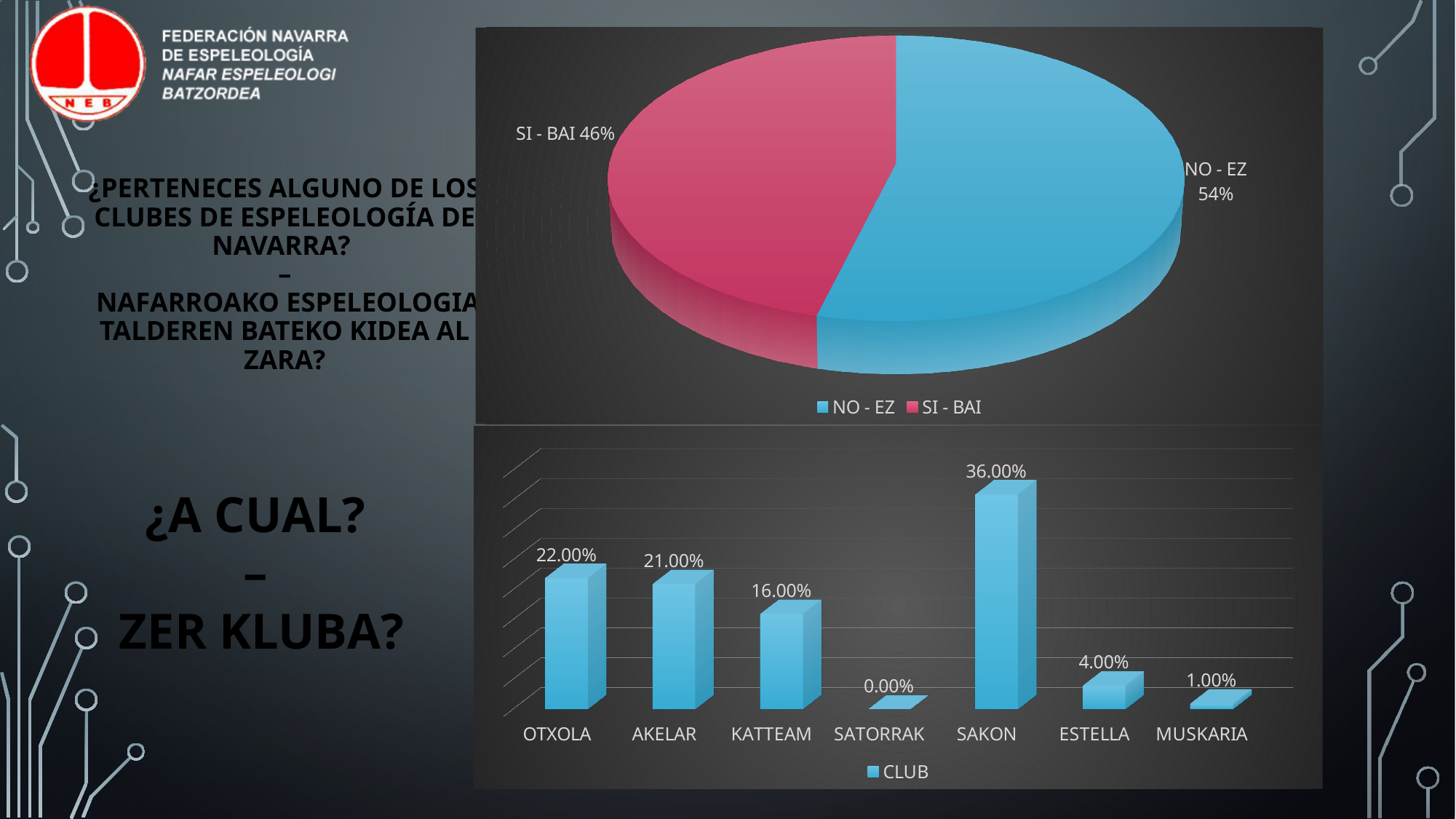
In the bar chart at the bottom of the slide, which club has the highest value? SAKON What kind of chart is the chart at the bottom of the slide? Bar chart In the bar chart at the bottom of the slide, what is the difference between the values for OTXOLA and AKELAR? 1.00% In the pie chart at the top of the slide, how many entries does the legend list? 2 In the pie chart at the top of the slide, what share does NO - EZ have? 54% In the bar chart at the bottom of the slide, what is the value for KATTEAM? 16.00% In the bar chart at the bottom of the slide, how many clubs are shown on the x axis? 7 What kind of chart is the chart at the top of the slide? Pie chart In the pie chart at the top of the slide, what share does SI - BAI have? 46% In the bar chart at the bottom of the slide, what is the value for SAKON? 36.00% In the pie chart at the top of the slide, which slice is larger, NO - EZ or SI - BAI? NO - EZ In the bar chart at the bottom of the slide, which club has the lowest value? SATORRAK